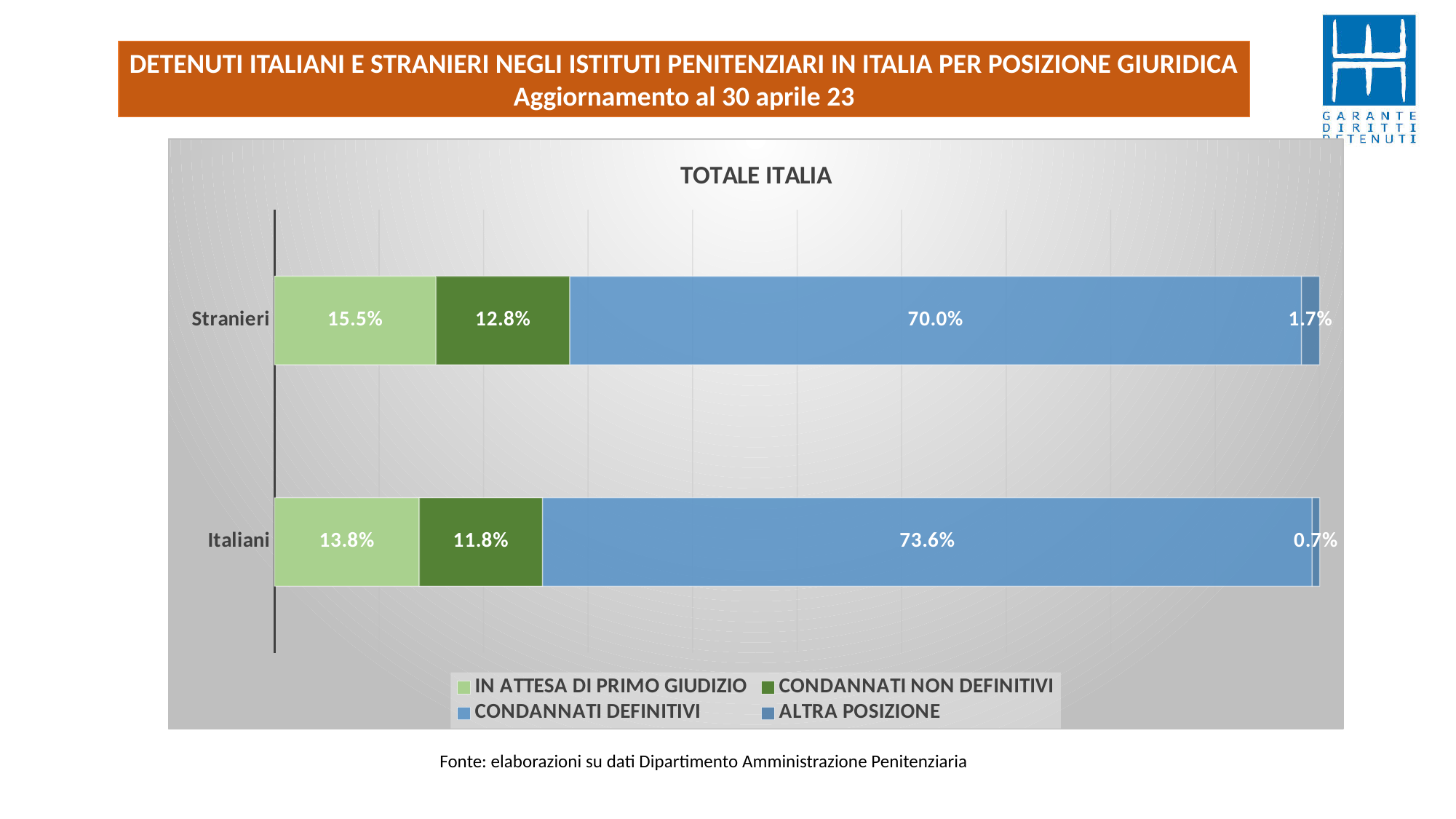
What is the difference between the IN ATTESA DI PRIMO GIUDIZIO values for Stranieri and Italiani? 1.7% What is the title of the chart? TOTALE ITALIA What kind of chart is shown? Stacked bar chart What is the value for CONDANNATI DEFINITIVI for Stranieri? 70.0% How many categories are shown on the chart? 2 Which category has the lower value for ALTRA POSIZIONE? Italiani What is the value for ALTRA POSIZIONE for Stranieri? 1.7% What is the value for CONDANNATI NON DEFINITIVI for Italiani? 11.8% How many series does the legend list? 4 What is the value for IN ATTESA DI PRIMO GIUDIZIO for Italiani? 13.8% What is the difference between the CONDANNATI DEFINITIVI values for Italiani and Stranieri? 3.6% Which category has the higher value for CONDANNATI DEFINITIVI, Stranieri or Italiani? Italiani